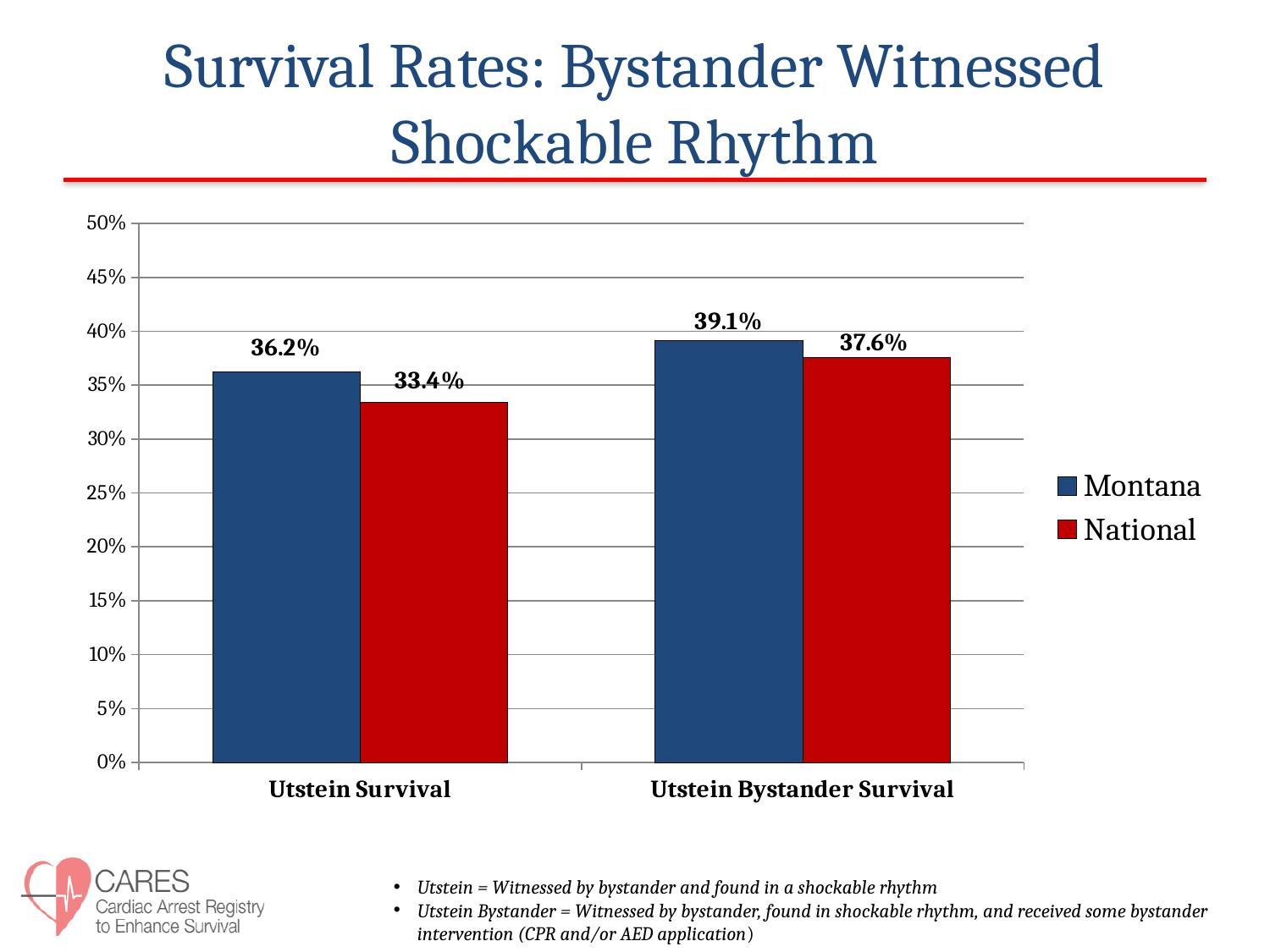
What kind of chart is shown on the slide? Bar chart Which is larger for Utstein Bystander Survival, Montana or National? Montana What is the Montana value for Utstein Bystander Survival? 39.1% What is the National value for Utstein Survival? 33.4% Which colour represents the National series in the legend? Red What is the National value for Utstein Bystander Survival? 37.6% What is the Montana value for Utstein Survival? 36.2% How many series does the legend list? 2 How many categories are shown on the x axis? 2 Which bar has the lowest value on the chart? National, Utstein Survival What is the difference between the Montana and National values for Utstein Survival? 2.8% Which bar has the highest value on the chart? Montana, Utstein Bystander Survival